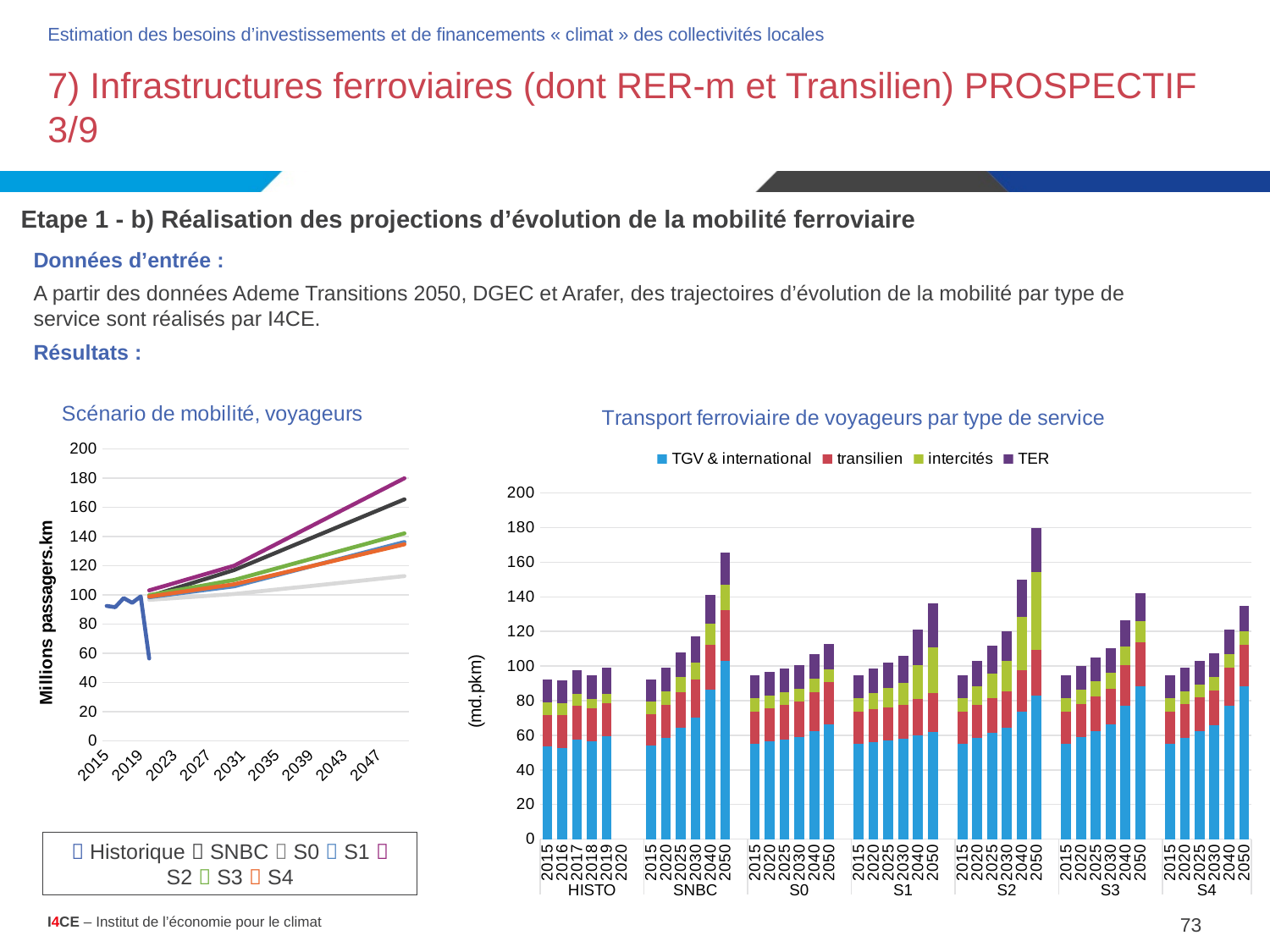
In the right chart 'Transport ferroviaire de voyageurs par type de service', how many scenario groups are shown along the x axis? 7 In the left chart 'Scénario de mobilité, voyageurs', do the scenario lines rise or fall between 2023 and 2047? rise In the right chart 'Transport ferroviaire de voyageurs par type de service', which scenario group has the shortest 2050 bar? S0 In the right chart 'Transport ferroviaire de voyageurs par type de service', is the total of the S0 2050 bar greater or less than 120? less What kind of chart is the right chart titled 'Transport ferroviaire de voyageurs par type de service'? stacked bar chart How many series does the legend of the left chart 'Scénario de mobilité, voyageurs' list? 7 What kind of chart is the left chart titled 'Scénario de mobilité, voyageurs'? line chart In the left chart 'Scénario de mobilité, voyageurs', is the value of the S1 line in 2047 greater or less than 160? less In the right chart 'Transport ferroviaire de voyageurs par type de service', is the total of the S2 2050 bar greater or less than 160? greater How many series does the legend of the right chart 'Transport ferroviaire de voyageurs par type de service' list? 4 What is the y-axis label of the left chart 'Scénario de mobilité, voyageurs'? Millions passagers.km In the right chart 'Transport ferroviaire de voyageurs par type de service', which scenario group has the tallest 2050 bar? S2